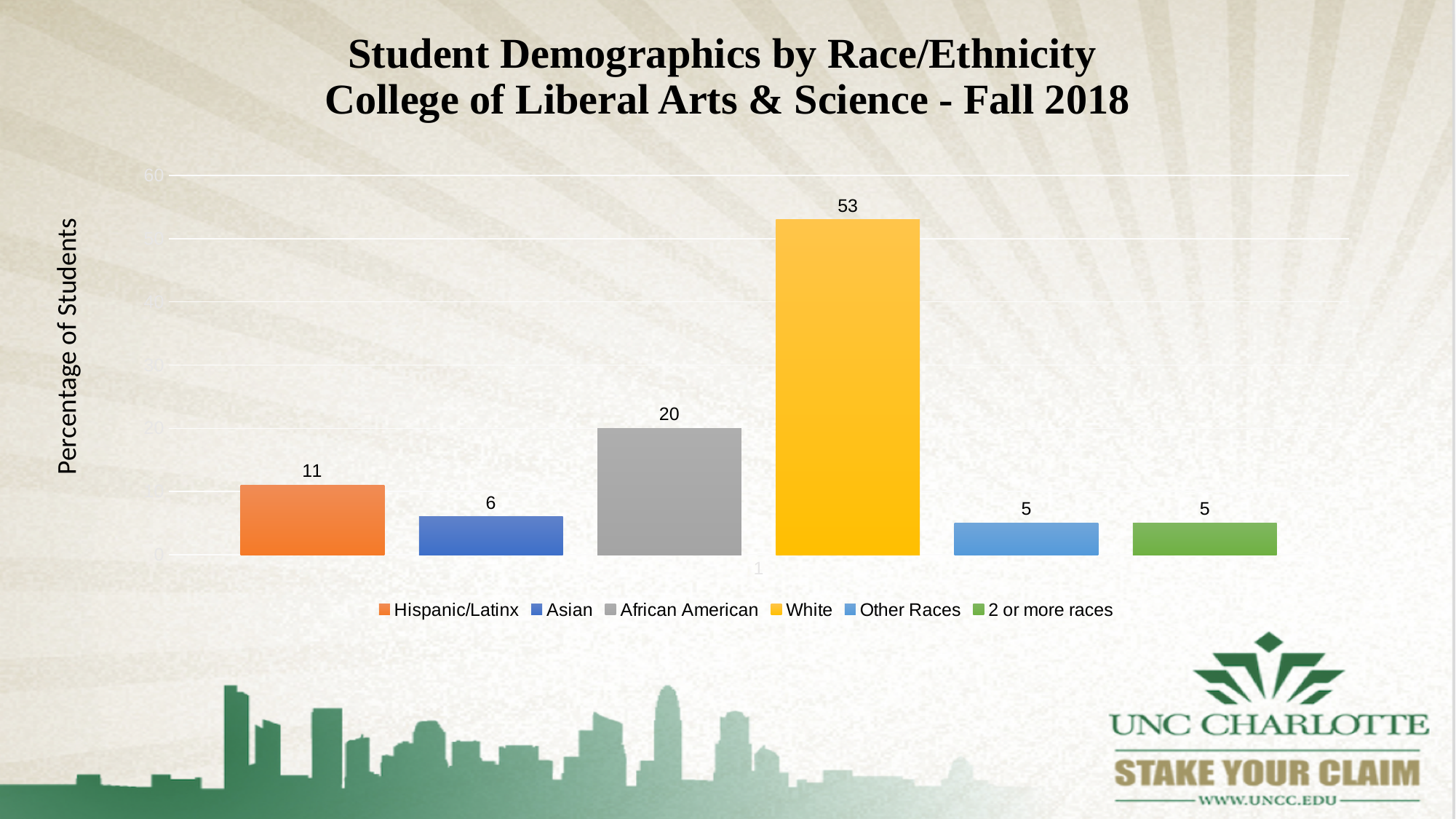
How many series does the legend list? 6 What is the value for African American? 20 What is the value for Other Races? 5 What kind of chart is shown on the slide? Bar chart Which is larger, the value for African American or the value for Hispanic/Latinx? African American What is the value for Asian? 6 What is the value for White? 53 Which group has the highest value? White What is the difference between the values for Hispanic/Latinx and Asian? 5 Is the value for White greater or less than 40? greater What is the difference between the values for White and African American? 33 What is the value for Hispanic/Latinx? 11